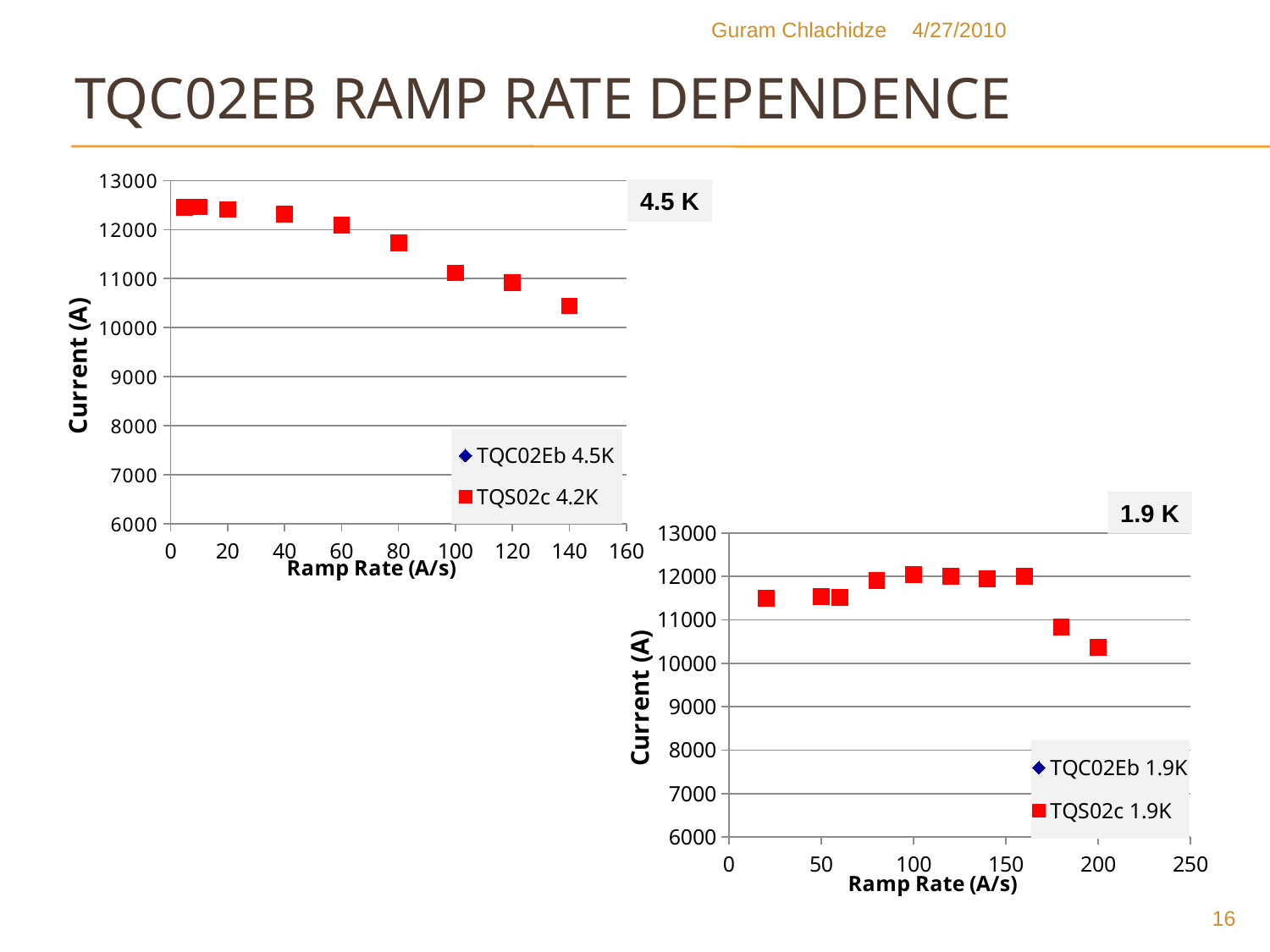
In the 4.5 K chart on the left, is the current at a ramp rate of 40 A/s greater or less than 12000? greater How many series does the legend of the 1.9 K chart on the right list? 2 In the 1.9 K chart on the right, at which ramp rate is the current lowest? 200 A/s What kind of chart is the 4.5 K chart on the left? scatter chart In the 4.5 K chart on the left, is the current at a ramp rate of 80 A/s greater or less than 11000? greater In the 4.5 K chart on the left, does the current rise or fall as the ramp rate increases? fall In the 4.5 K chart on the left, is the current at a ramp rate of 140 A/s greater or less than 11000? less In the 1.9 K chart on the right, which has the higher current: a ramp rate of 80 A/s or 200 A/s? 80 A/s In the 4.5 K chart on the left, at which ramp rate is the current lowest? 140 A/s What is the x-axis title of the 1.9 K chart on the right? Ramp Rate (A/s)